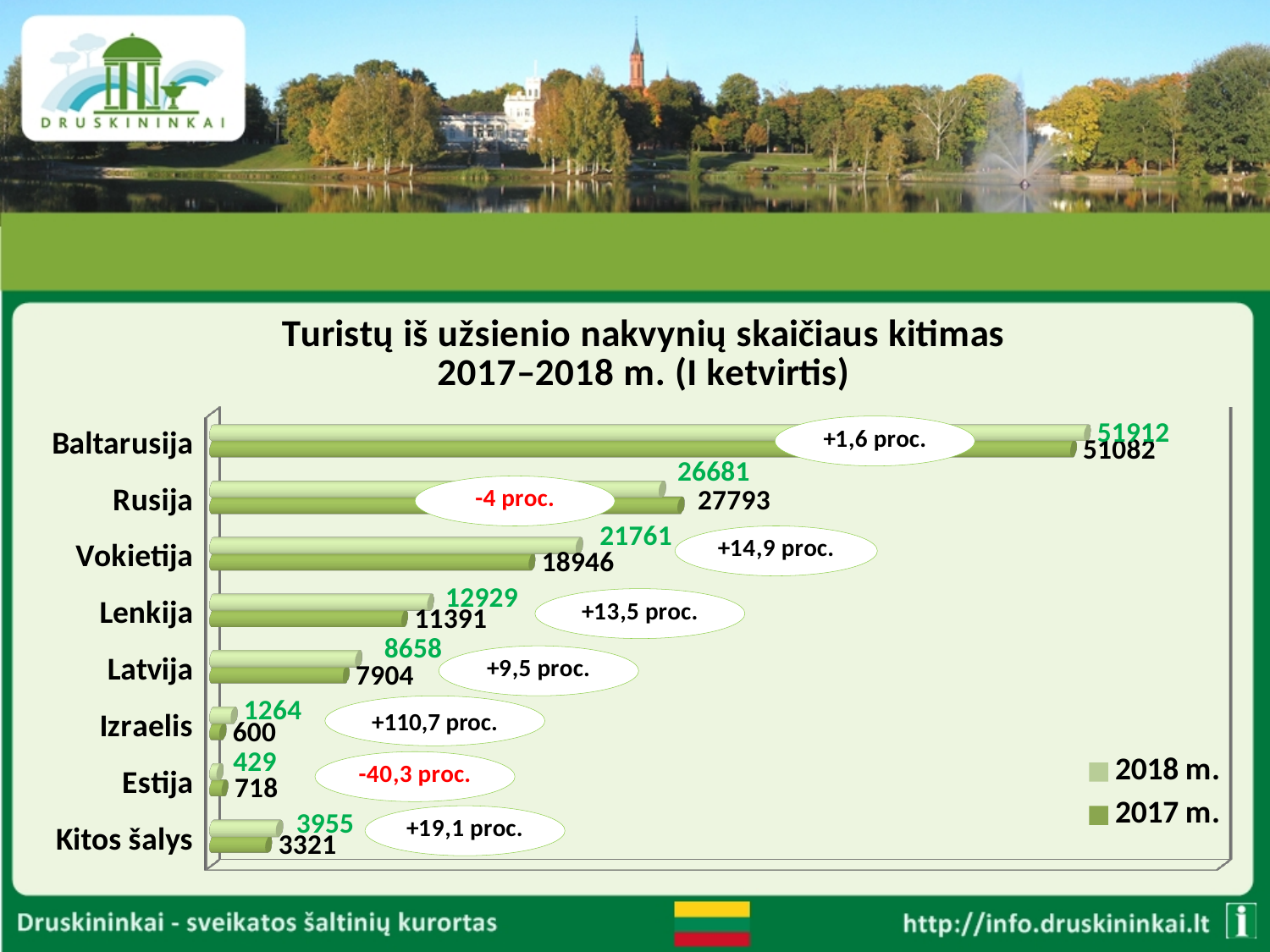
Which category has the lowest 2018 m. value? Estija What is the title of the chart? Turistų iš užsienio nakvynių skaičiaus kitimas 2017–2018 m. (I ketvirtis) What is the 2017 m. value for Rusija? 27793 How many series does the legend list? 2 What is the difference between the 2018 m. and 2017 m. values for Lenkija? 1538 Which category has the highest 2018 m. value? Baltarusija What is the 2017 m. value for Izraelis? 600 Which is larger for Estija, the 2018 m. value or the 2017 m. value? 2017 m. How many categories are shown on the chart? 8 What is the 2018 m. value for Vokietija? 21761 What kind of chart is shown on the slide? bar chart What is the 2018 m. value for Baltarusija? 51912